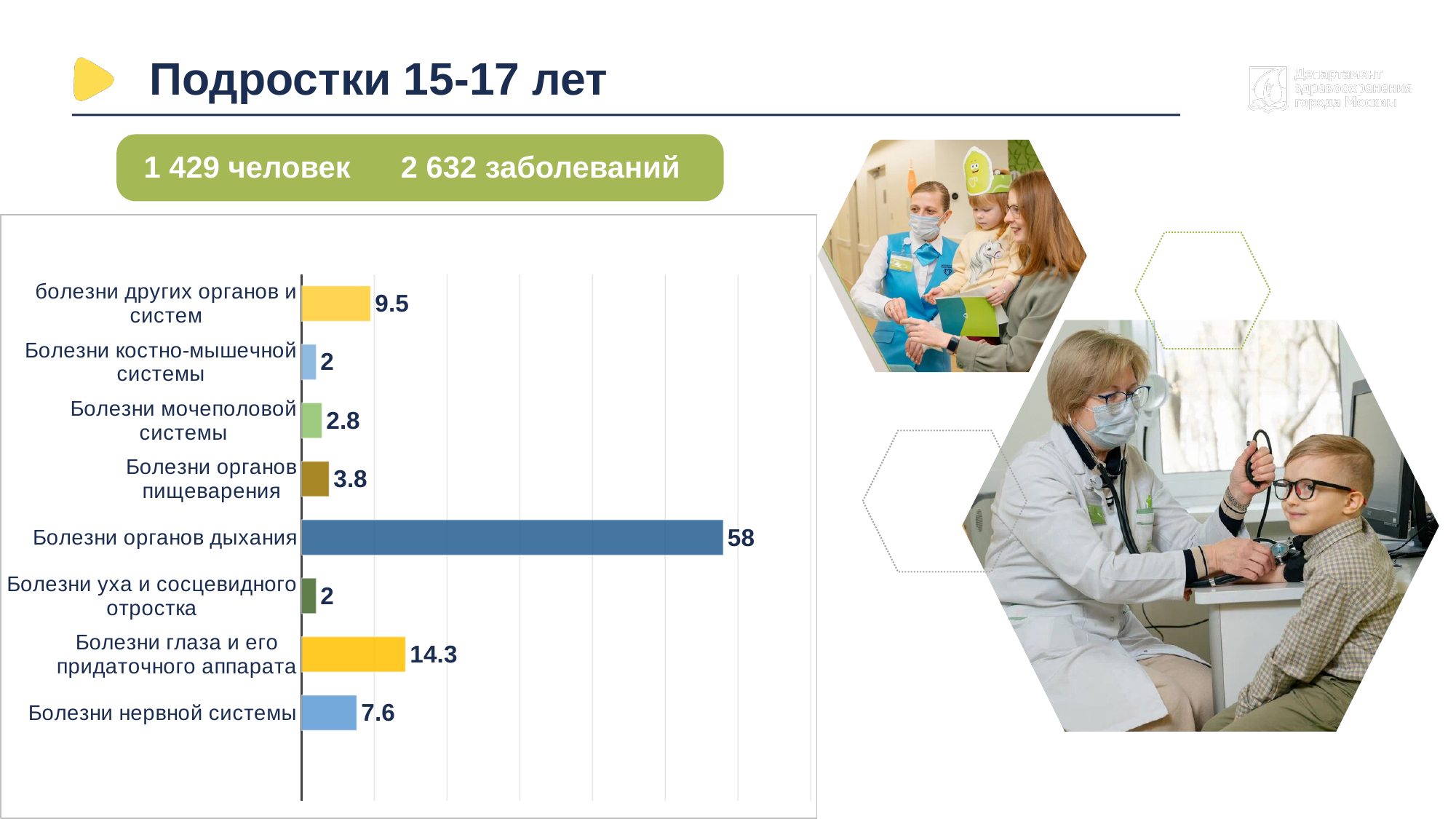
What value is shown for Болезни органов дыхания? 58 Which is larger: the value for болезни других органов и систем or the value for Болезни нервной системы? болезни других органов и систем Which category has the highest value? Болезни органов дыхания What is the difference between the values for Болезни органов дыхания and Болезни глаза и его придаточного аппарата? 43.7 What is the difference between the values for болезни других органов и систем and Болезни нервной системы? 1.9 How many categories are shown in the chart? 8 What value is shown for Болезни мочеполовой системы? 2.8 What value is shown for Болезни глаза и его придаточного аппарата? 14.3 What colour is the bar for Болезни органов дыхания? Blue What value is shown for Болезни нервной системы? 7.6 What value is shown for Болезни органов пищеварения? 3.8 What kind of chart is shown on the slide? Bar chart